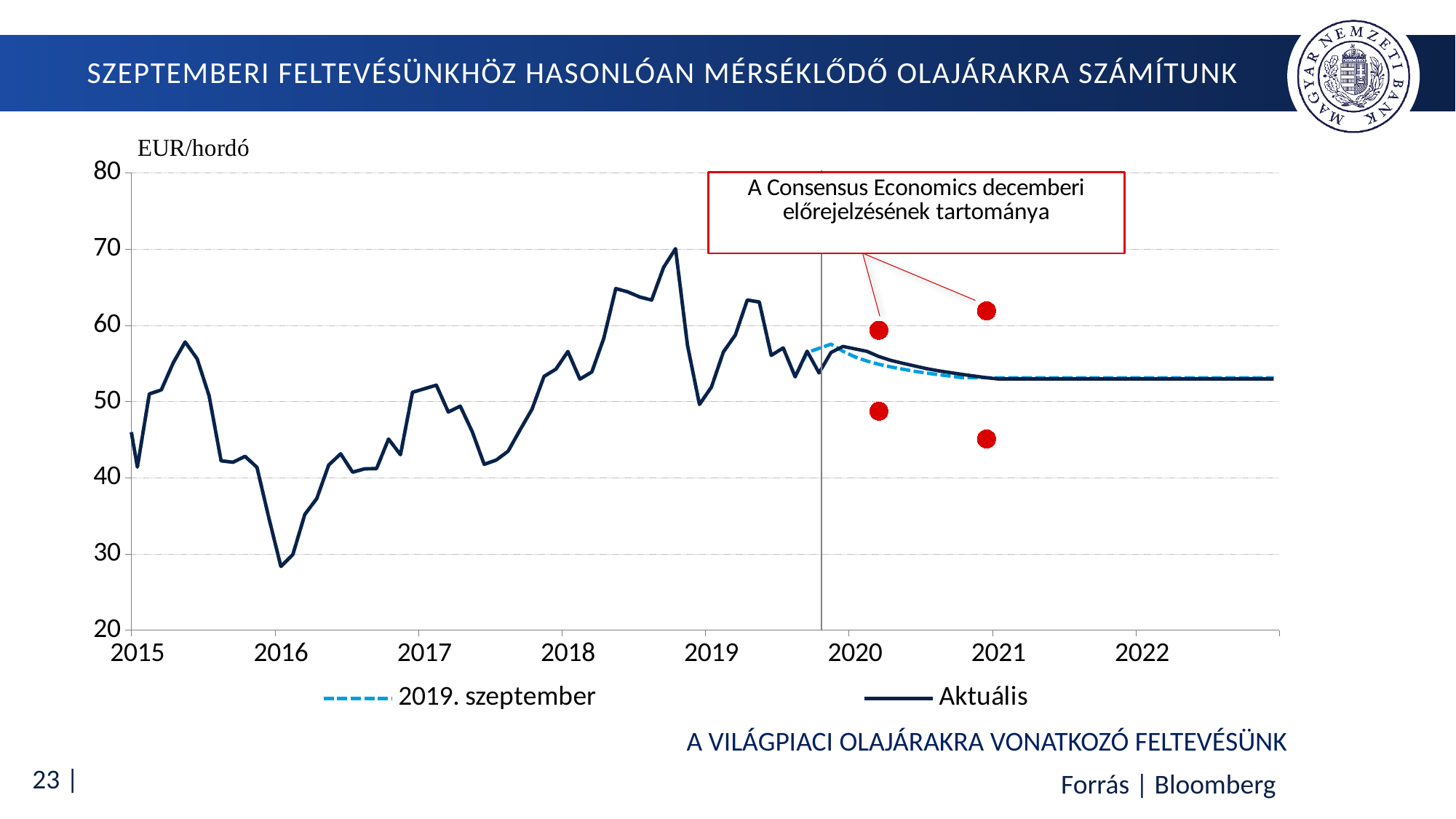
In mid-2020, which series is higher, 2019. szeptember or Aktuális? Aktuális What is the title printed below the chart? A VILÁGPIACI OLAJÁRAKRA VONATKOZÓ FELTEVÉSÜNK What are the two series named in the legend? 2019. szeptember and Aktuális What kind of chart is shown on the slide? line chart How many series does the legend list? 2 In which year does the Aktuális line reach its lowest value? 2016 Between 2020 and 2021, does the Aktuális line rise or fall? fall Is the lowest value of the Aktuális line greater or less than 40? less Is the highest value of the Aktuális line greater or less than 65? greater How many year labels are shown on the x axis? 8 In which year does the Aktuális line reach its highest value? 2018 Is the value of the Aktuális line at the end of 2022 greater or less than 60? less